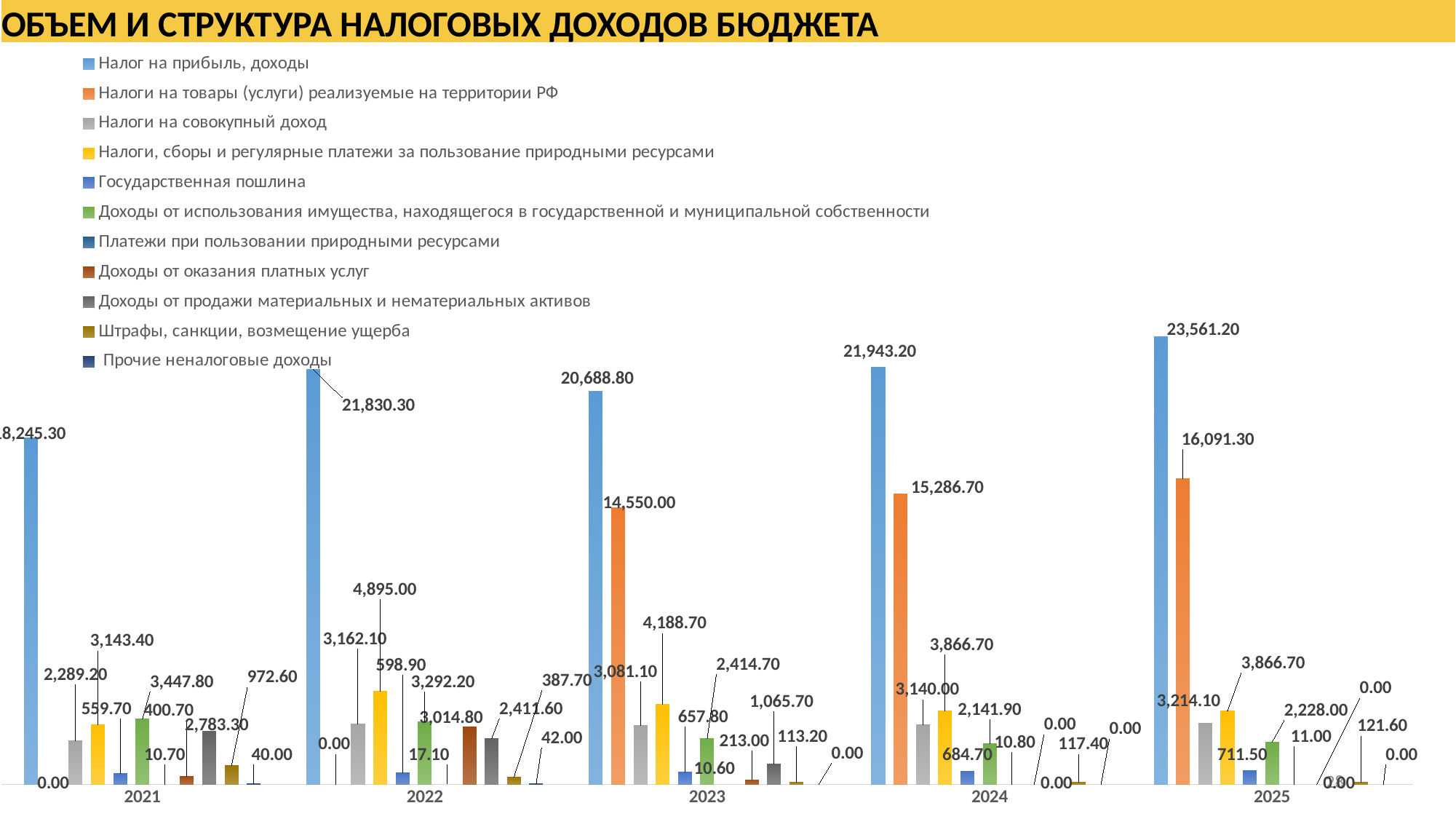
What is the value of 'Налог на прибыль, доходы' for 2022? 21,830.30 What is the value of 'Налоги на товары (услуги) реализуемые на территории РФ' for 2025? 16,091.30 In which year is 'Налог на прибыль, доходы' the highest? 2025 Which year has the larger value of 'Налог на прибыль, доходы': 2022 or 2023? 2022 How many series does the legend list? 11 Do the values of 'Налоги на товары (услуги) реализуемые на территории РФ' rise or fall from 2023 to 2025? rise What is the title of the chart on the slide? ОБЪЕМ И СТРУКТУРА НАЛОГОВЫХ ДОХОДОВ БЮДЖЕТА By how much does 'Налог на прибыль, доходы' in 2025 exceed its value in 2024? 1,618.00 What kind of chart is shown on the slide? bar chart What is the value of 'Налоги на товары (услуги) реализуемые на территории РФ' for 2023? 14,550.00 What is the value of 'Налог на прибыль, доходы' for 2025? 23,561.20 How many years are shown on the x axis of the chart? 5